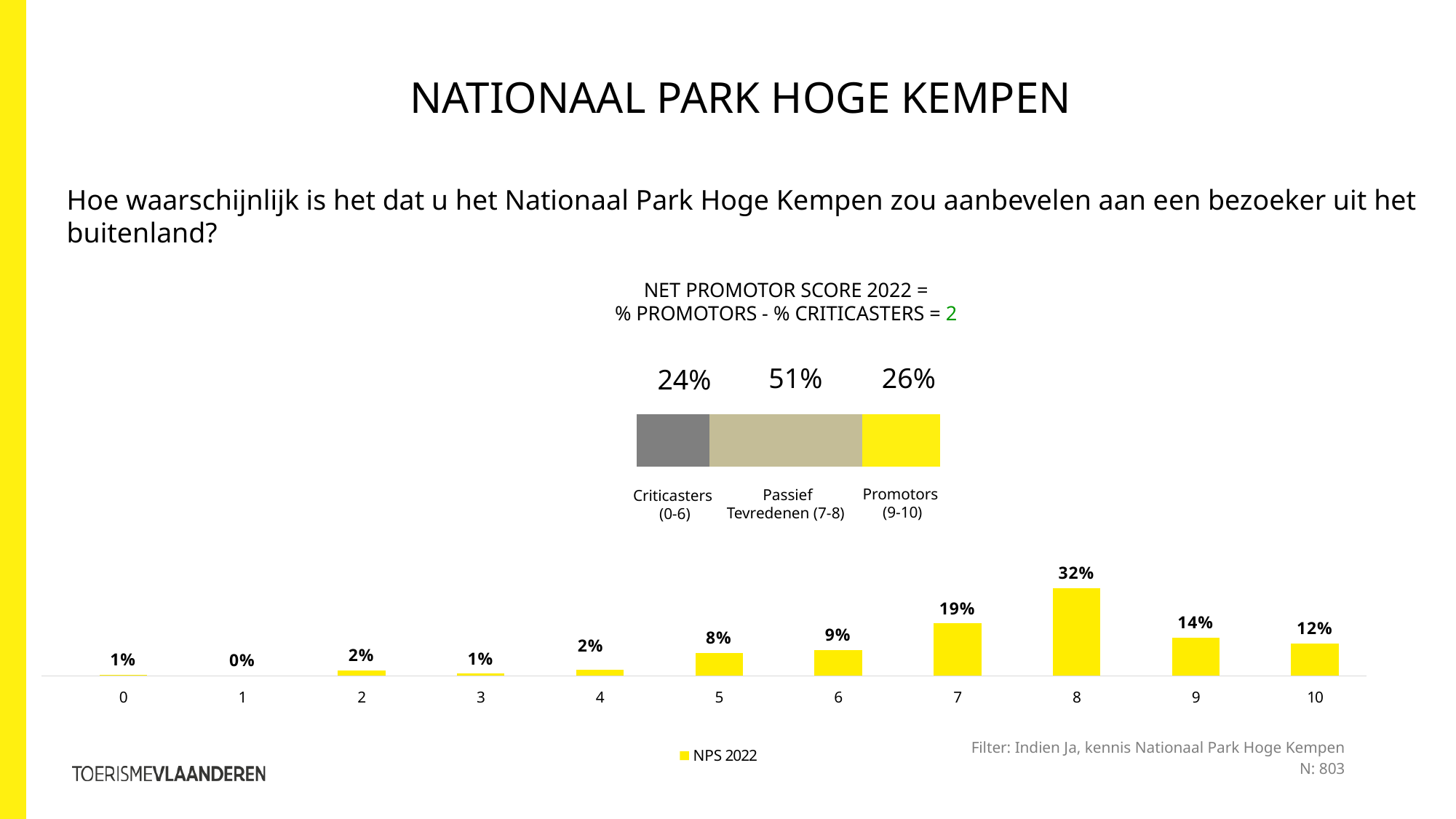
In the bar chart at the bottom of the slide, what is the value for score 10? 12% In the stacked bar in the middle of the slide, what is the difference between the Promotors (9-10) share and the Criticasters (0-6) share? 2% In the bar chart at the bottom of the slide, what is the value for score 7? 19% What kind of chart is shown at the bottom of the slide? Bar chart In the bar chart at the bottom of the slide, which score has the highest value? 8 How many series does the legend of the bar chart at the bottom of the slide list? 1 In the bar chart at the bottom of the slide, what is the value for score 8? 32% In the stacked bar in the middle of the slide, what is the share for Passief Tevredenen (7-8)? 51% In the bar chart at the bottom of the slide, what is the difference between the values for score 8 and score 9? 18% In the bar chart at the bottom of the slide, which score has the lowest value? 1 In the bar chart at the bottom of the slide, which is larger: the value for score 5 or the value for score 6? 6 How many score categories are shown on the x axis of the bar chart at the bottom of the slide? 11